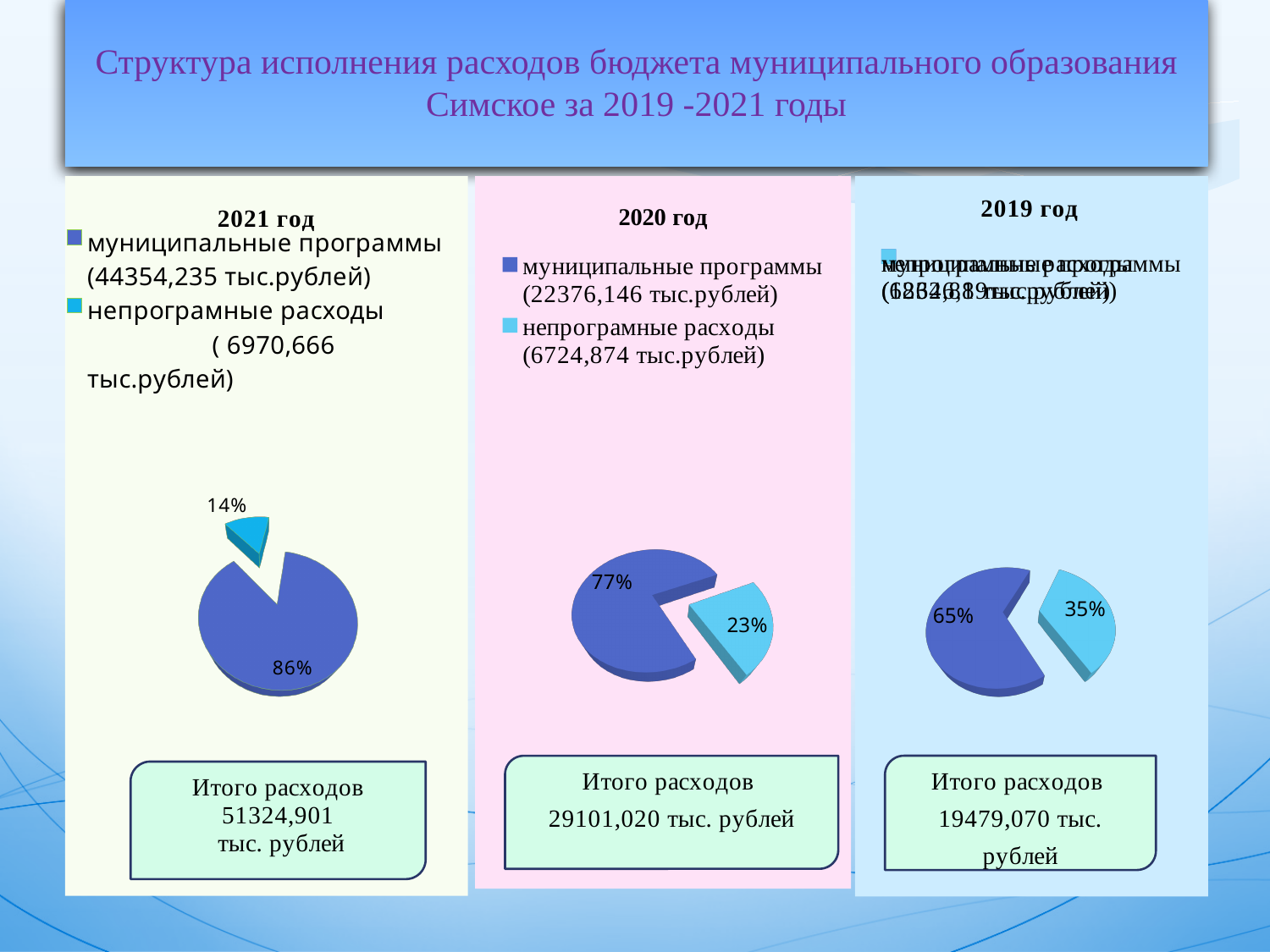
What is the difference in percentage points between the two slices of the 2020 год pie chart? 54 On the 2021 год pie chart, what share is shown for муниципальные программы? 86% Which year's pie chart shows the smallest share for the light blue (непрограмные расходы) slice? 2021 год On the 2020 год pie chart, what share is shown for муниципальные программы? 77% What kind of chart is used in each of the three year panels? Pie chart On the 2021 год pie chart, which category has the larger share: муниципальные программы or непрограмные расходы? муниципальные программы On the 2019 год pie chart, what share is shown for the larger (dark blue) slice? 65% How many slices does the 2020 год pie chart have? 2 How many series does the legend of the 2021 год chart list? 2